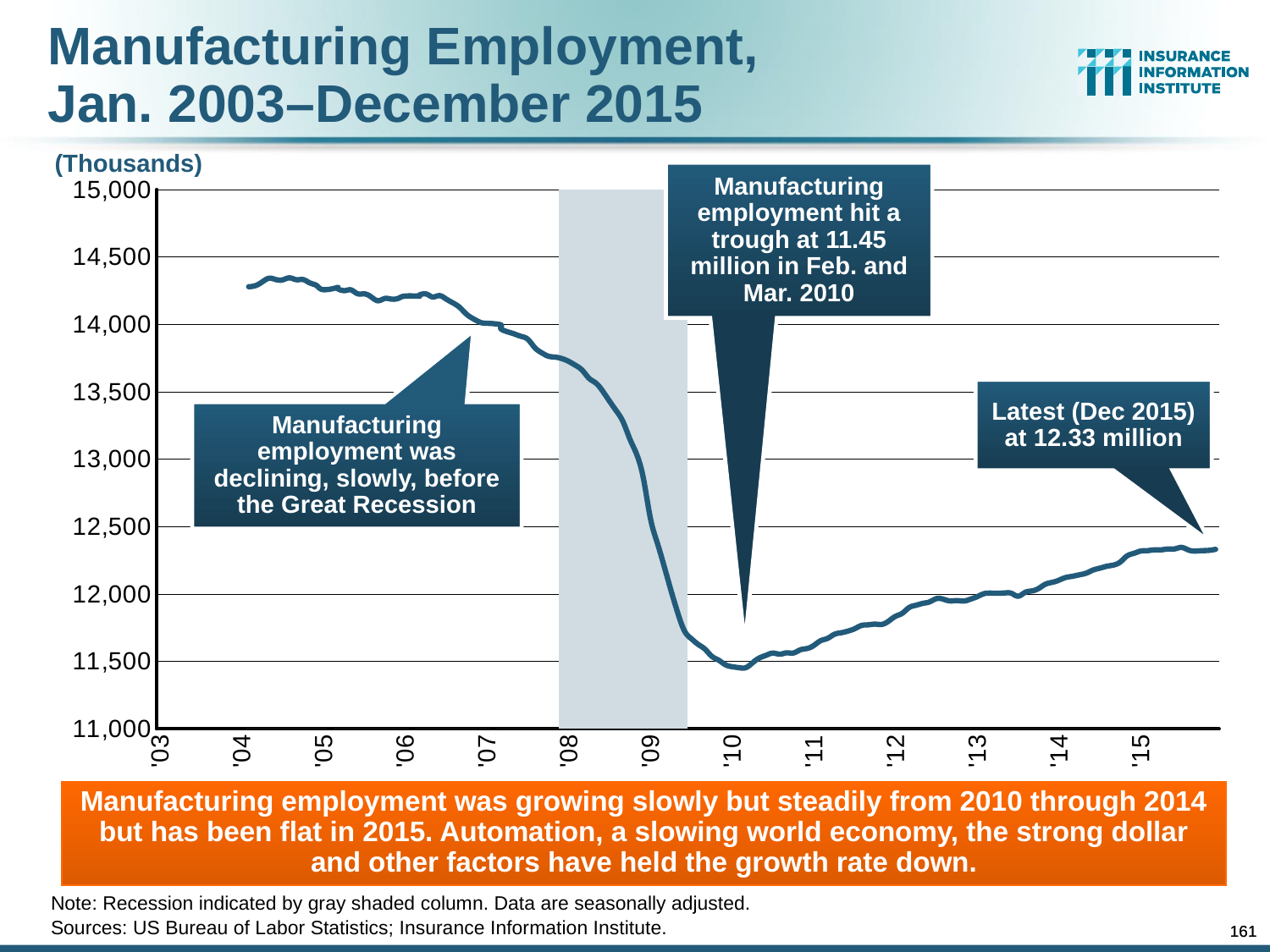
What value did manufacturing employment hit at its trough in Feb. and Mar. 2010? 11.45 million Is the value for manufacturing employment in '04 greater or less than 14,000? greater What kind of chart is shown on the slide? line chart Is the value for manufacturing employment in '14 greater or less than 12,000? greater Does manufacturing employment rise or fall from 2010 through 2014? rise What is the latest (Dec 2015) value of manufacturing employment shown on the chart? 12.33 million What does the gray shaded column on the chart indicate? Recession Which is larger, manufacturing employment in '04 or in '15? '04 What is the difference between the Dec 2015 value (12.33 million) and the trough value (11.45 million)? 0.88 million Does manufacturing employment rise or fall between 2007 and early 2010? fall In which months did manufacturing employment hit its trough according to the chart annotation? Feb. and Mar. 2010 Is the value for manufacturing employment in '11 greater or less than 12,000? less